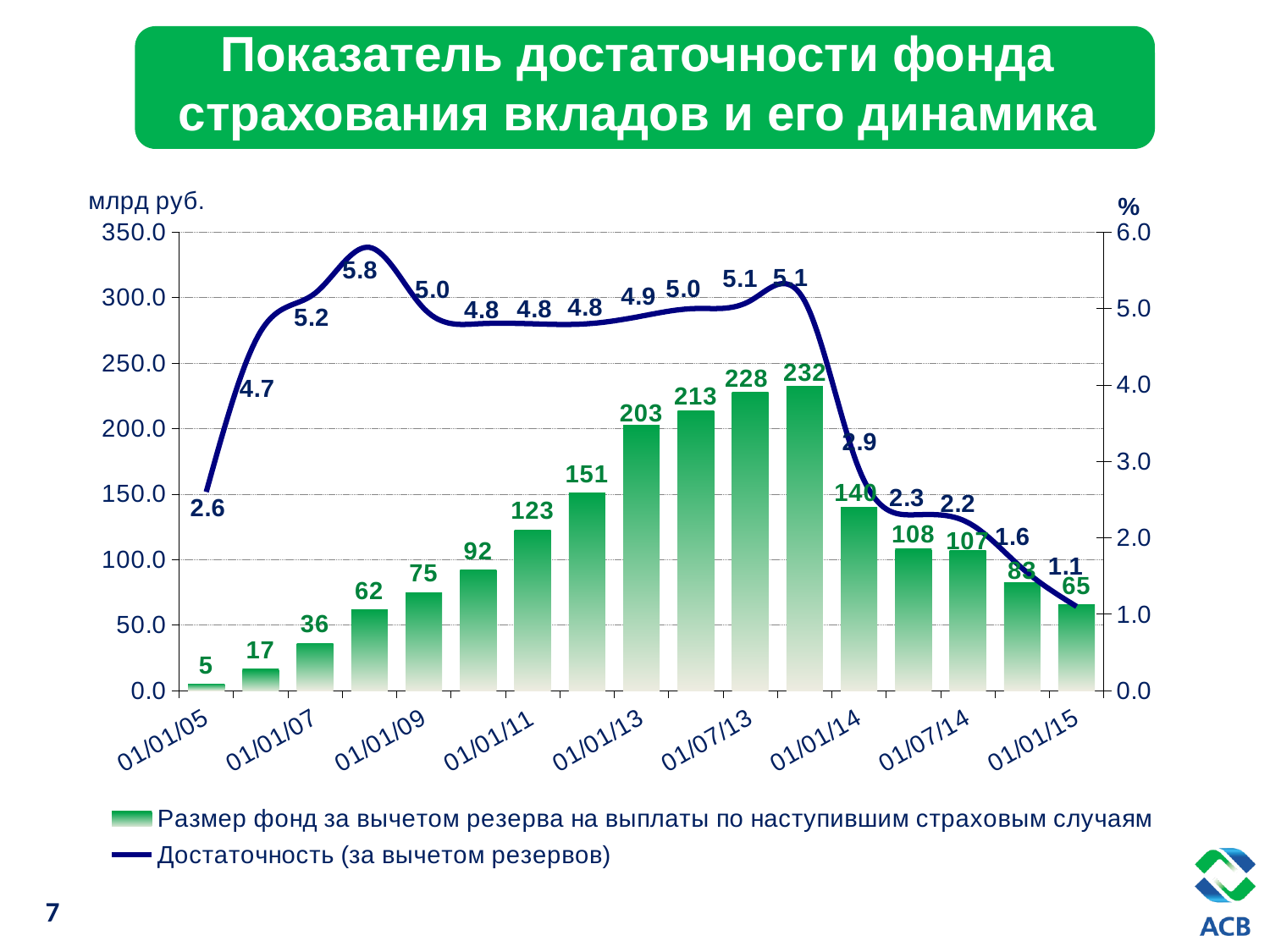
What is the difference between the fund size at 01/01/14 and at 01/01/15? 75 What kind of chart is shown on the slide? Combination bar and line chart Do the fund size bars rise or fall from 01/01/05 to 01/01/13? Rise What is the adequacy ratio (line) at 01/01/05? 2.6 What is the highest value shown for the bar series (fund size)? 232 What is the lowest value shown for the adequacy line? 1.1 What is the fund size (bar) at 01/01/15? 65 Which date has the larger fund size bar, 01/01/13 or 01/07/13? 01/07/13 What is the highest value shown for the adequacy line? 5.8 How many bars are plotted in the chart? 17 How many series does the legend list? 2 What is the fund size (bar) at 01/01/11? 123